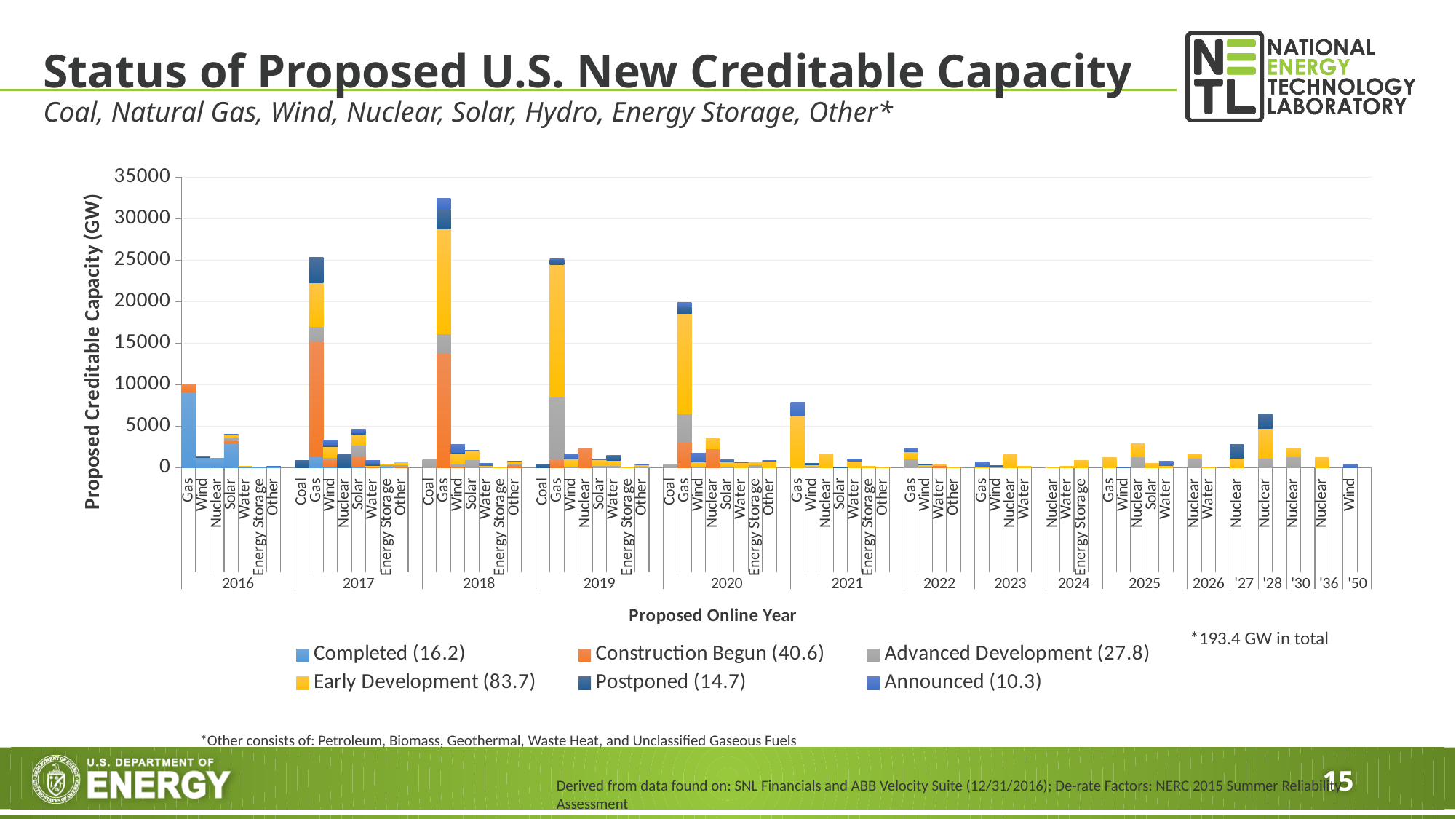
What kind of chart is shown on the slide? Stacked bar chart Which is larger, the Gas bar for 2017 or the Gas bar for 2020? Gas 2017 Is the value for Gas in 2018 greater or less than 30000? greater What is the label of the vertical axis? Proposed Creditable Capacity (GW) How many fuel categories are shown under the 2016 group? 7 Which bar is the tallest in the chart? Gas in 2018 Is the value for Gas in 2020 greater or less than 15000? greater Is the value for Solar in 2016 greater or less than 5000? less How many proposed online year groups are shown on the x axis? 16 How many series does the legend list? 6 Which legend entry has the largest total in parentheses? Early Development (83.7)